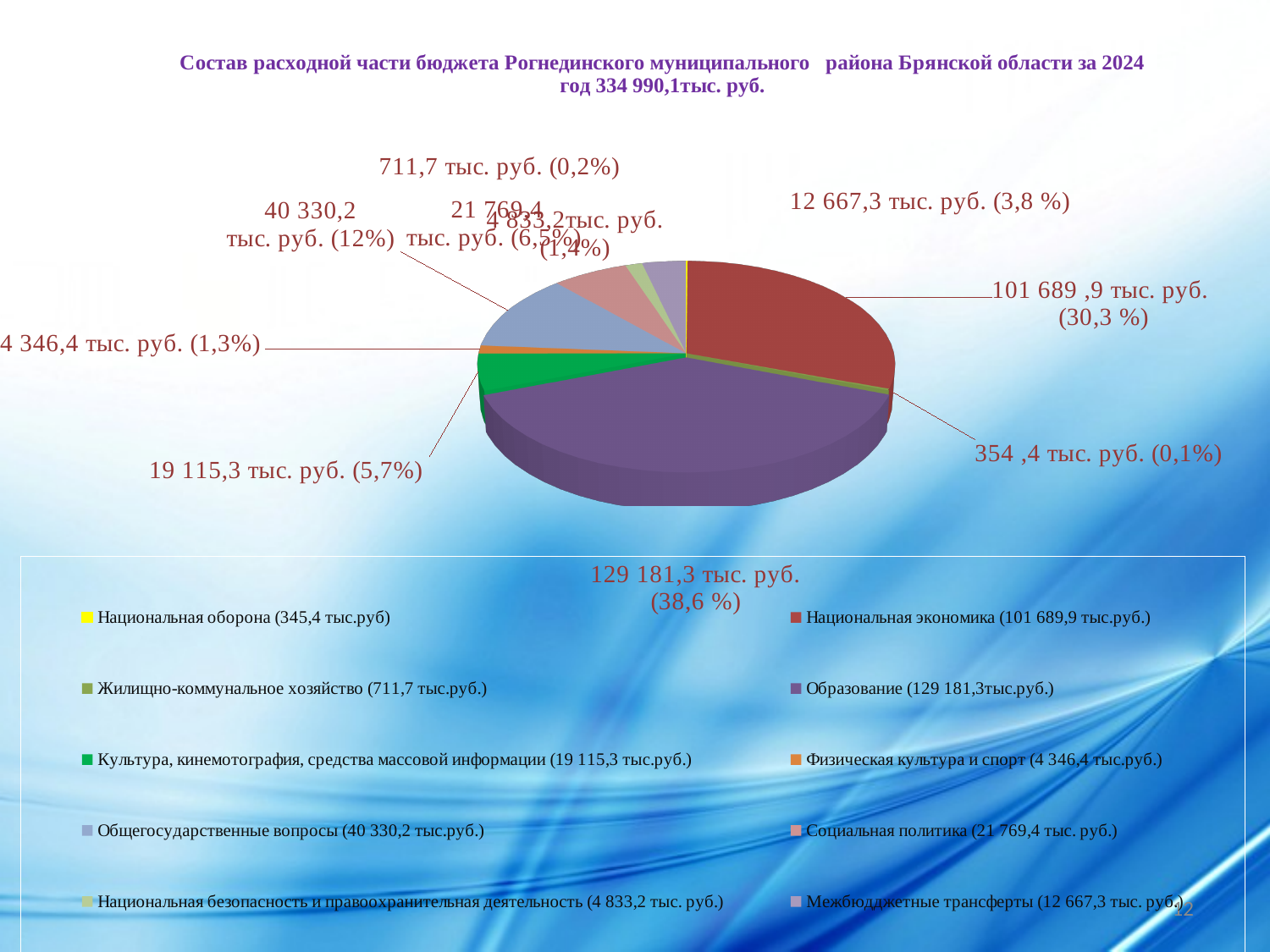
What is the difference between the values for Образование and Национальная экономика? 27 491,4 тыс. руб. What share of the expenditure does Национальная экономика account for? 30,3 % What share of the expenditure does Жилищно-коммунальное хозяйство account for? 0,2% According to the chart title, what is the total expenditure of the budget for 2024? 334 990,1 тыс. руб. What is the value shown for Национальная экономика? 101 689,9 тыс. руб. Which is larger: Культура, кинемотография, средства массовой информации or Межбюджетные трансферты? Культура, кинемотография, средства массовой информации What is the value shown for Общегосударственные вопросы? 40 330,2 тыс. руб. Which category has the largest share of the budget expenditure? Образование What share of the expenditure does Образование account for? 38,6 % How many expenditure categories does the legend list? 10 What kind of chart is shown on the slide? pie chart